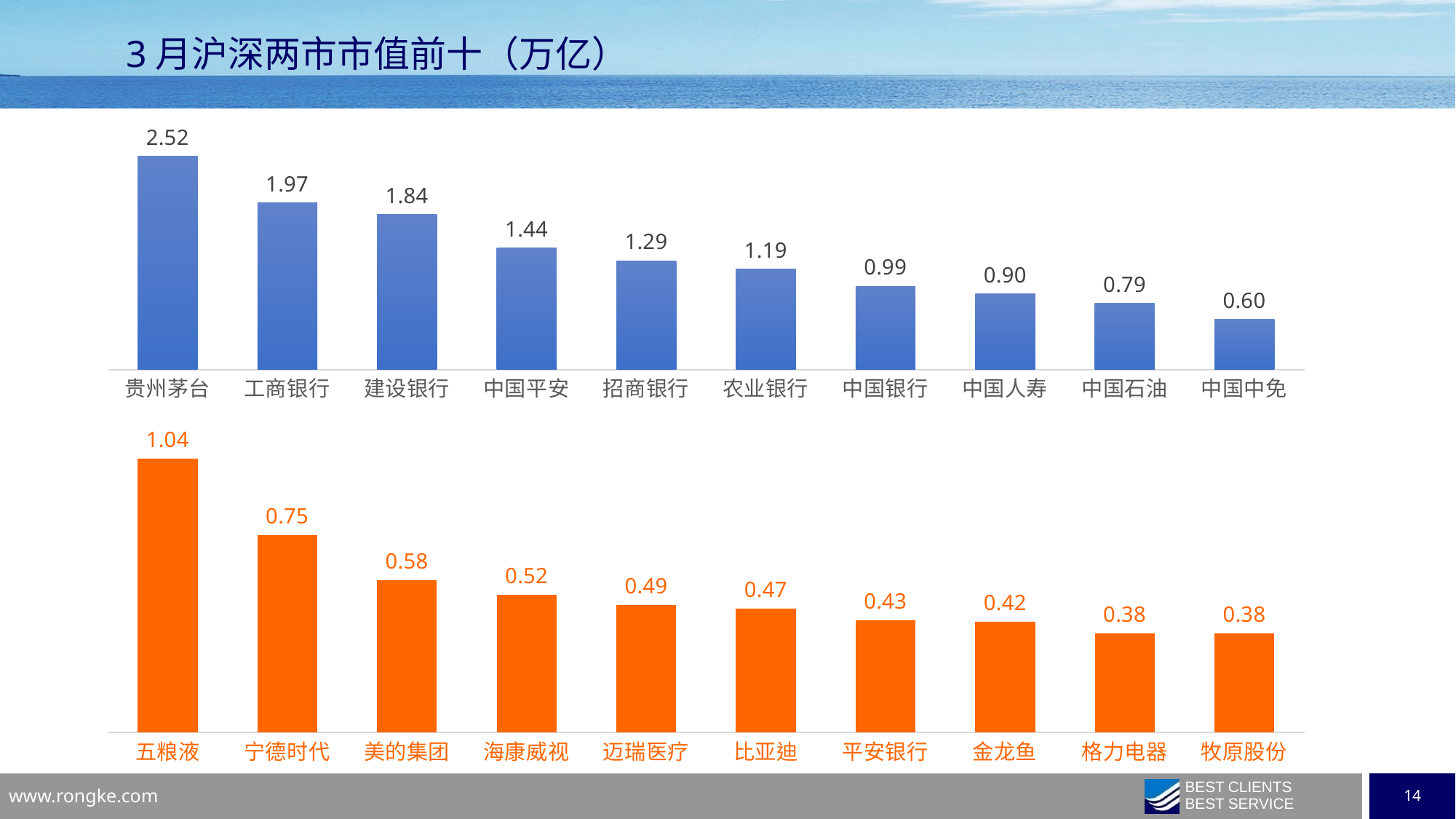
In the bottom chart, what is the value for 宁德时代? 0.75 What kind of chart is the top chart? Bar chart In the top chart, what is the value for 招商银行? 1.29 In the top chart, what is the value for 贵州茅台? 2.52 How many categories are shown in the bottom chart? 10 In the top chart, which is larger, the value for 中国平安 or the value for 农业银行? 中国平安 In the bottom chart, do the values rise or fall from left to right along the x axis? Fall In the bottom chart, which category has the highest value? 五粮液 In the bottom chart, what is the value for 比亚迪? 0.47 In the top chart, which category has the lowest value? 中国中免 In the bottom chart, what is the difference between the values for 五粮液 and 美的集团? 0.46 In the top chart, what is the difference between the values for 工商银行 and 建设银行? 0.13